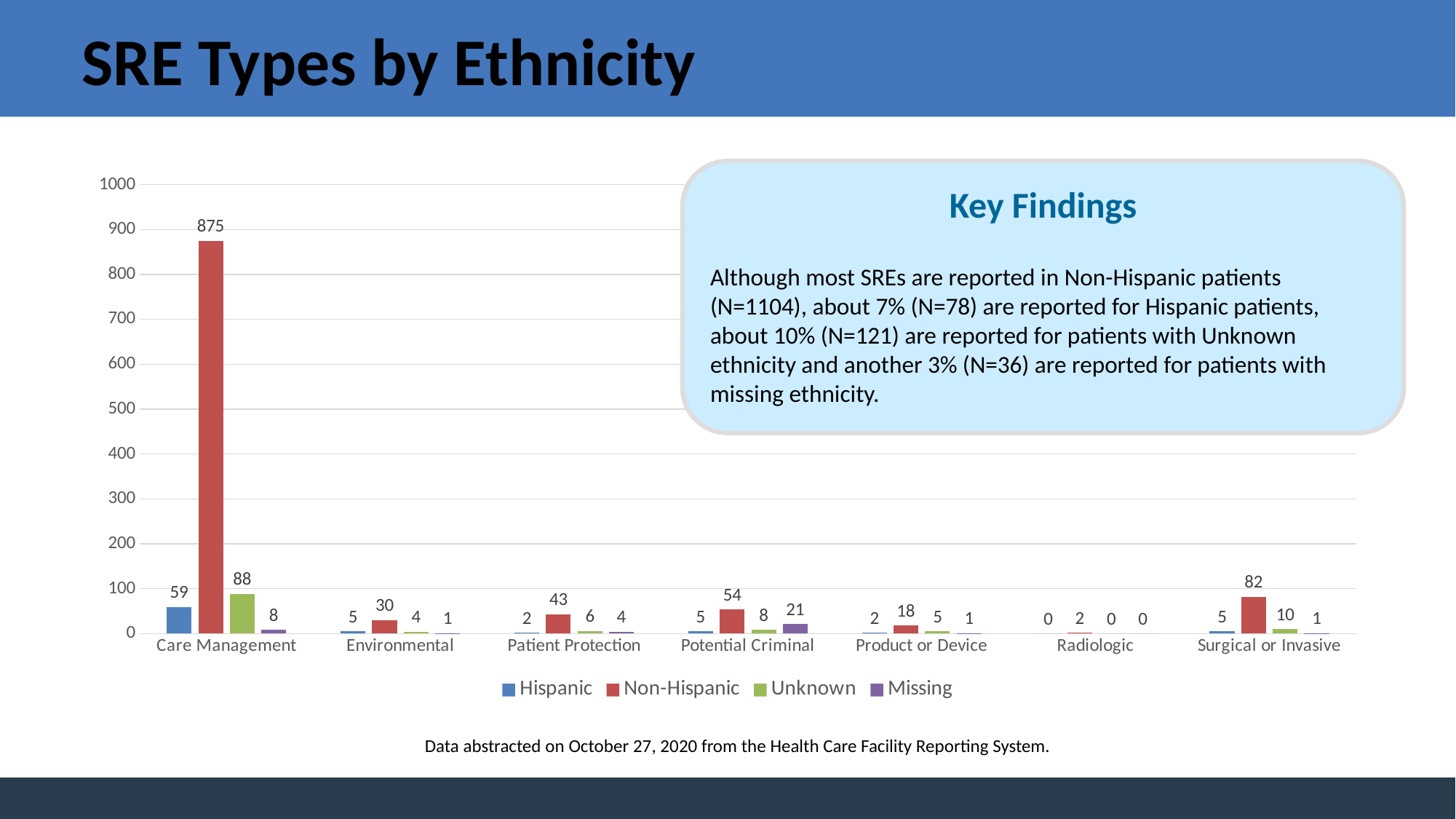
What is the Missing value for Potential Criminal? 21 Which category has the lowest Non-Hispanic value? Radiologic What is the Non-Hispanic value for Care Management? 875 Which is larger, the Hispanic value for Care Management or the Unknown value for Care Management? Unknown value for Care Management What kind of chart is shown on the slide? Bar chart Which category has the highest Non-Hispanic value? Care Management What is the total of the four values for Environmental? 40 Which series is shown in red in the legend? Non-Hispanic What is the Unknown value for Surgical or Invasive? 10 How many categories are shown on the x axis? 7 How many series does the legend list? 4 What is the difference between the Non-Hispanic values for Surgical or Invasive and Patient Protection? 39